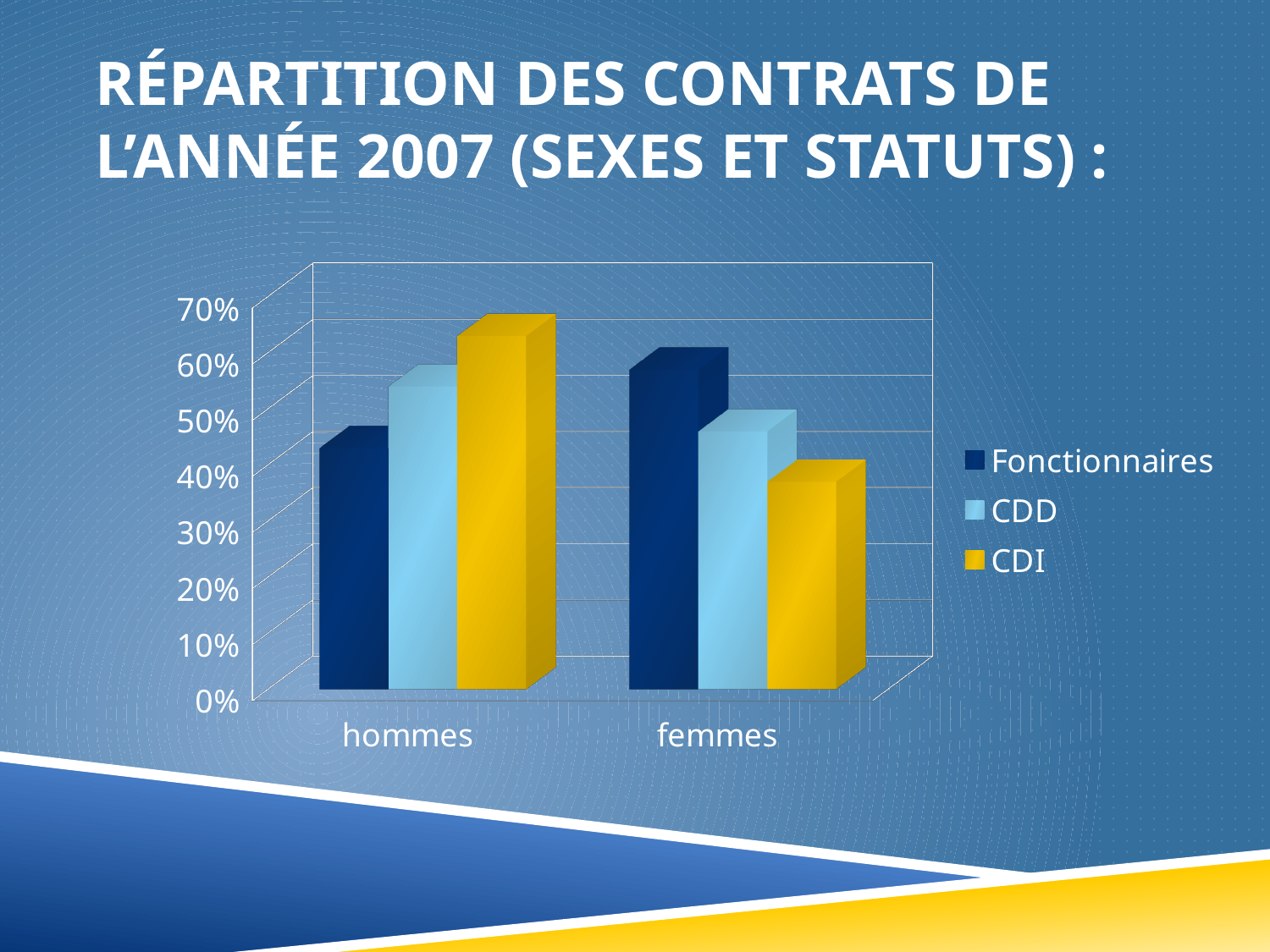
Is the CDI value for hommes greater or less than 60%? greater For the femmes category, which series has the lowest bar? CDI For the hommes category, which series has the lowest bar? Fonctionnaires For the femmes category, which series has the highest bar? Fonctionnaires How many series does the legend list? 3 Which colour represents the CDD series in the legend? light blue What kind of chart is shown on the slide? bar chart Is the CDI value for femmes greater or less than 50%? less For the hommes category, which series has the highest bar? CDI How many categories are shown on the x axis of the chart? 2 Which is larger, the CDI value for hommes or the CDI value for femmes? hommes Is the Fonctionnaires value for hommes greater or less than 50%? less